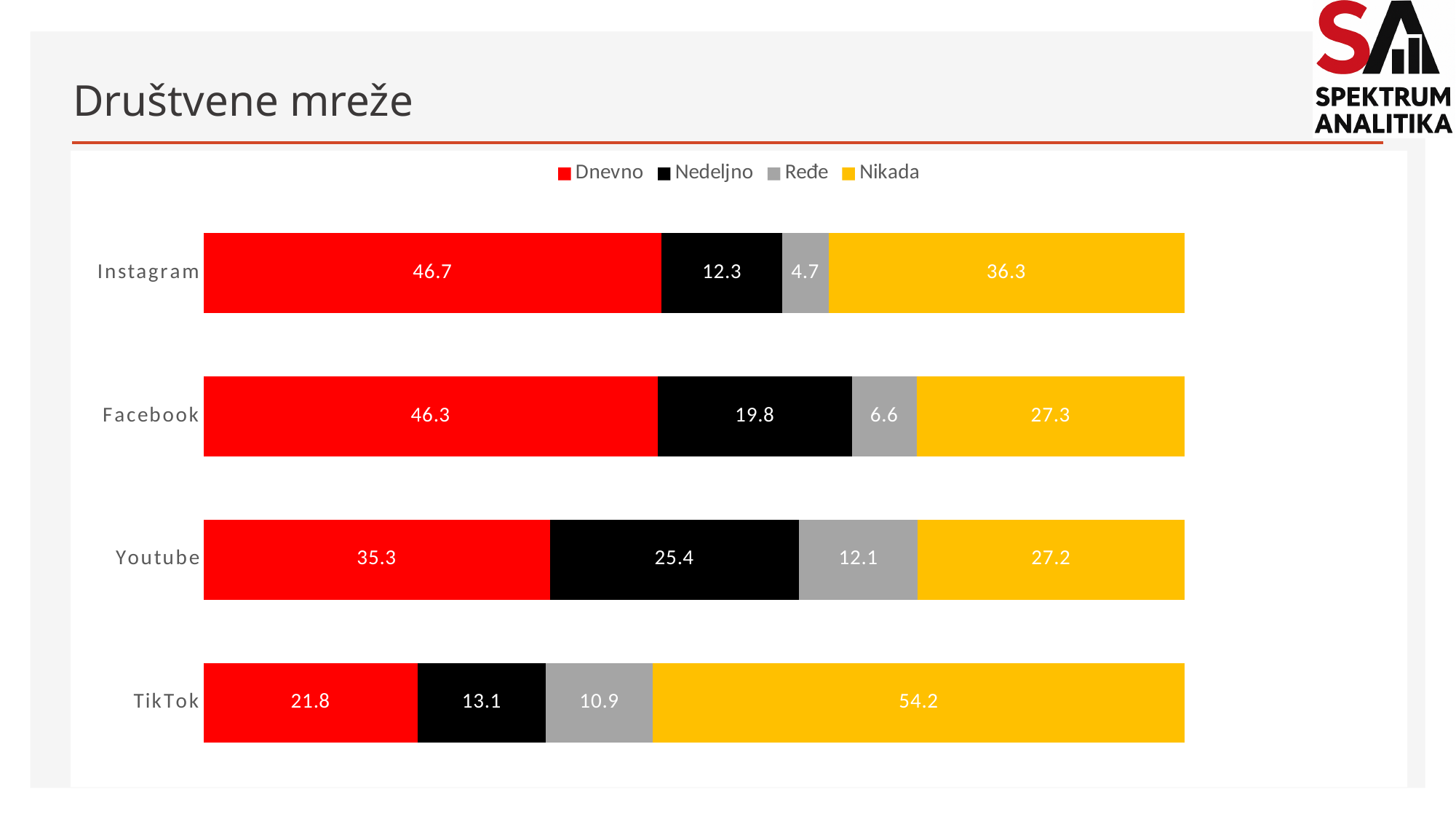
How many series does the legend list? 4 Which social network has the lowest Ređe value? Instagram Which social network has the highest Nikada value? TikTok What is the Ređe value for Facebook? 6.6 What is the difference between the Nikada value for TikTok and the Nikada value for Instagram? 17.9 What kind of chart is shown on the slide? Stacked bar chart What is the Nedeljno value for Youtube? 25.4 How many social networks are shown in the chart? 4 What is the Nikada value for TikTok? 54.2 What is the total of the stacked bar for Instagram? 100 Which is larger: the Nedeljno value for Facebook or the Nedeljno value for Youtube? Youtube What is the Dnevno value for Instagram? 46.7